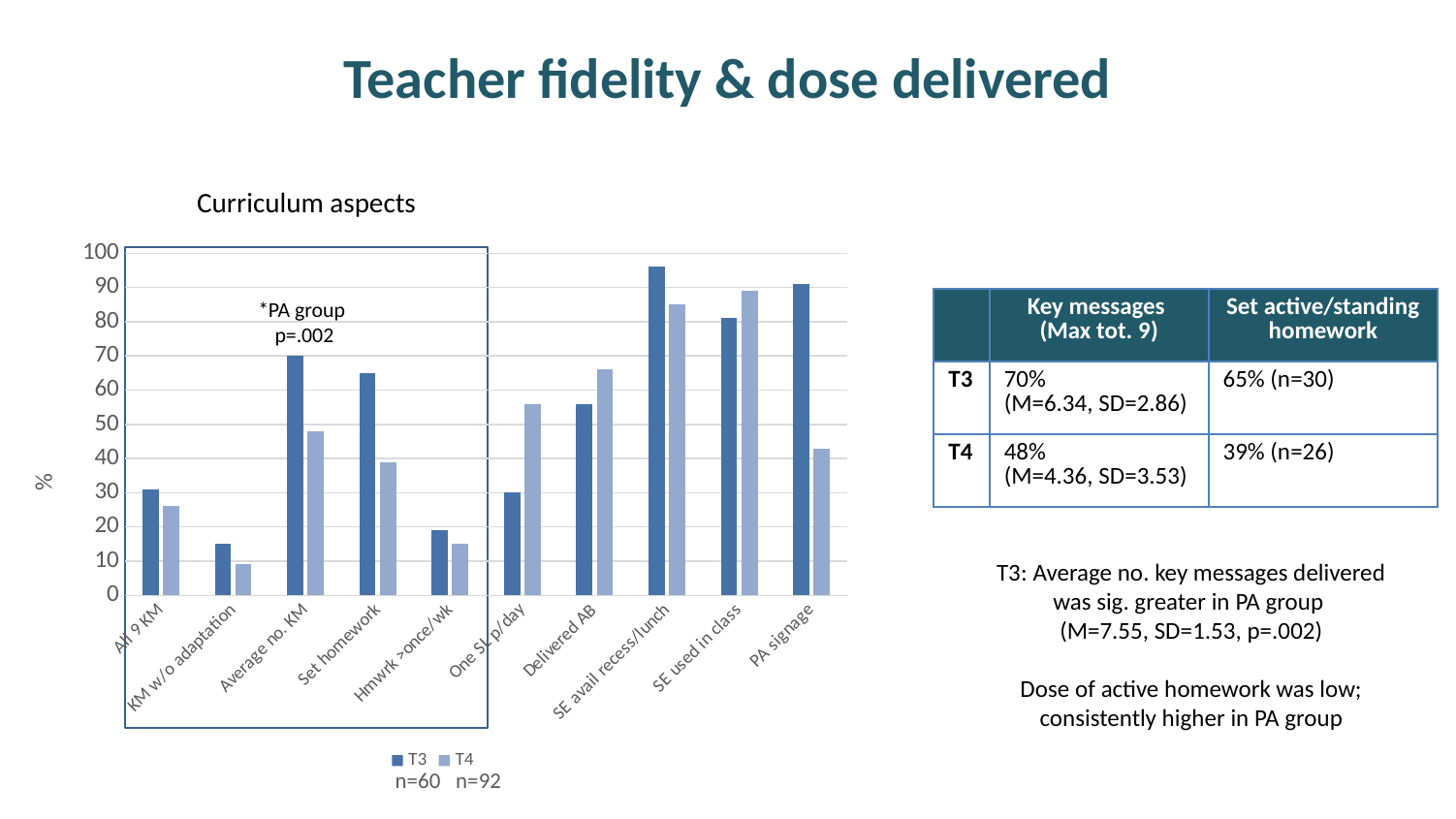
What is the T3 value for Average no. KM? 70 Which category has the lowest T4 value? KM w/o adaptation For PA signage, which series has the larger value, T3 or T4? T3 How many categories are shown along the x axis of the chart? 10 For One SL p/day, which series has the larger value, T3 or T4? T4 Is the T3 value for Hmwrk >once/wk greater or less than 30? less Is the T4 value for SE used in class greater or less than 80? greater Which category has the highest T3 value? SE avail recess/lunch How many series does the chart legend list? 2 Which category has the lowest T3 value? KM w/o adaptation What kind of chart is shown on the slide? Bar chart